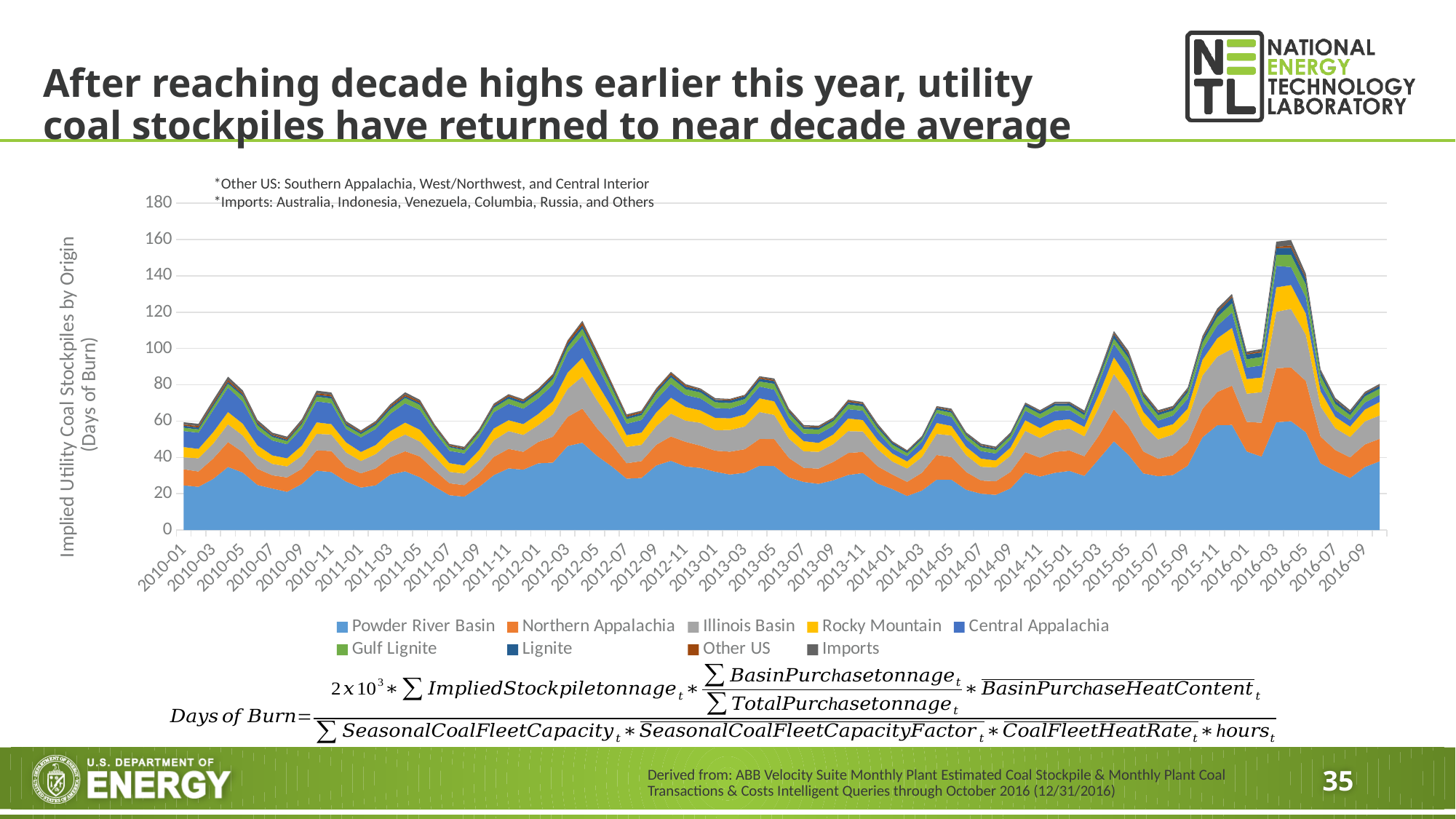
Is the total stacked value at the peak around 2012-05 greater or less than 100? greater Is the total stacked value around 2011-07 greater or less than 60? less Is the total stacked value at 2010-01 greater or less than 80? less What kind of chart is shown on the slide? Stacked area chart Does the total stacked value rise or fall between 2015-07 and 2015-11? rise Which series contributes the largest share of the stockpiles across the chart? Powder River Basin What is the title of the vertical axis? Implied Utility Coal Stockpiles by Origin (Days of Burn) Does the total stacked value rise or fall between 2016-04 and 2016-07? fall Which series is plotted at the bottom of the stack (the largest blue area)? Powder River Basin How many series does the legend list? 9